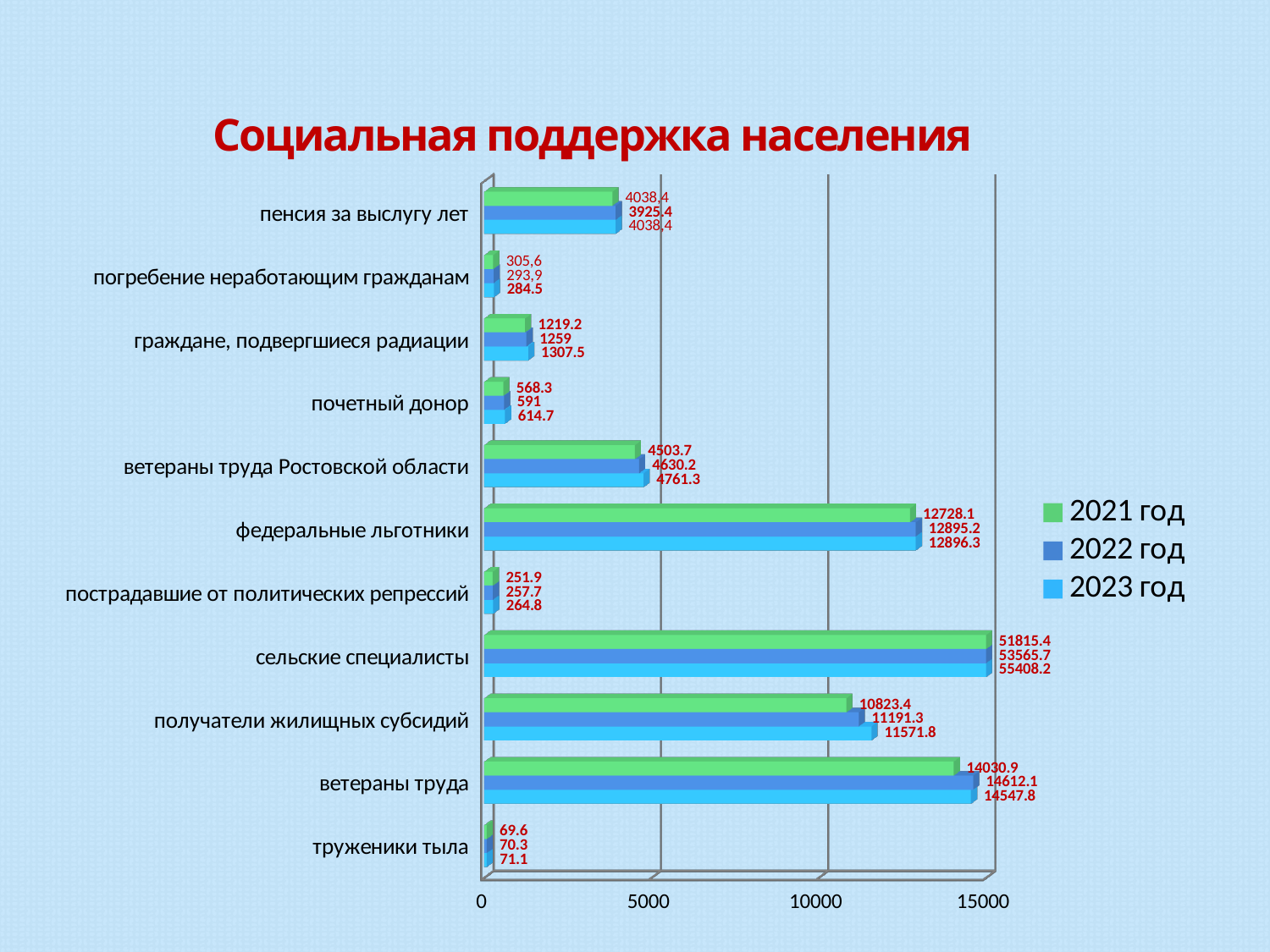
What is the difference between the 2023 год and 2021 год values for получатели жилищных субсидий? 748.4 Which category has the highest value in 2023 год? сельские специалисты Do the values for почетный донор rise or fall from 2021 год to 2023 год? rise How many categories are shown on the chart? 11 What is the title of the chart? Социальная поддержка населения Which category has the lowest value in 2021 год? труженики тыла How many series does the legend list? 3 What kind of chart is shown on the slide? bar chart For ветераны труда, which is larger: the 2022 год value or the 2023 год value? 2022 год What is the value for ветераны труда in 2022 год? 14612.1 What is the value for сельские специалисты in 2023 год? 55408.2 What is the value for почетный донор in 2022 год? 591